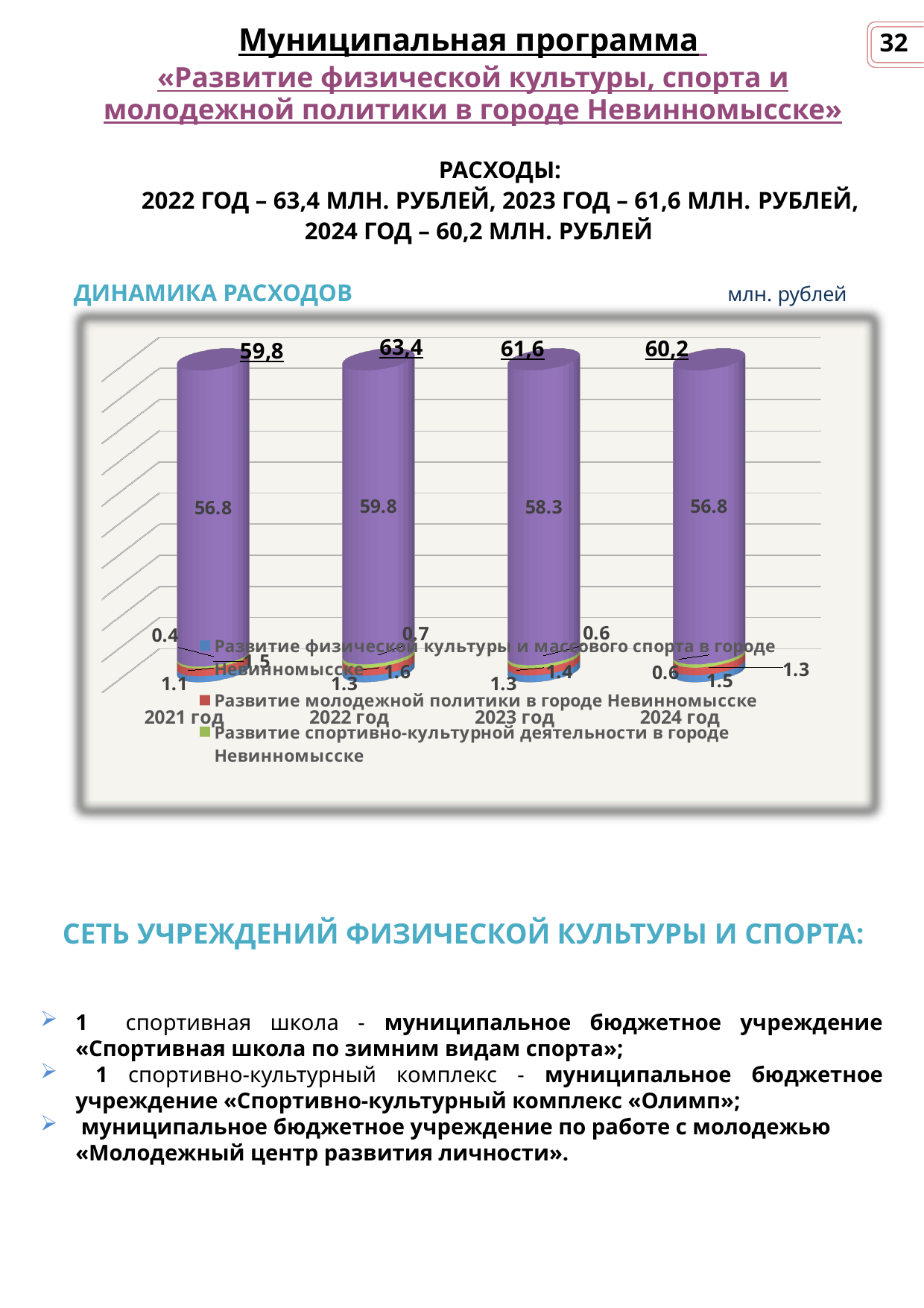
Which year has the larger total, 2023 год or 2024 год? 2023 год Do the total values rise or fall from 2022 год to 2024 год? fall What is the total expenditure shown above the bar for 2022 год in the ДИНАМИКА РАСХОДОВ chart? 63,4 What is the total value labelled above the bar for 2021 год? 59,8 What kind of chart is ДИНАМИКА РАСХОДОВ? bar chart How many years are shown on the x axis of the ДИНАМИКА РАСХОДОВ chart? 4 Which year has the highest total in the ДИНАМИКА РАСХОДОВ chart? 2022 год What unit is indicated at the top right of the ДИНАМИКА РАСХОДОВ chart? млн. рублей What is the value of the large purple segment in the bar for 2023 год? 58.3 What is the value of the large purple segment in the bar for 2022 год? 59.8 Which year has the lowest total in the ДИНАМИКА РАСХОДОВ chart? 2021 год What is the difference between the totals for 2022 год and 2023 год? 1,8